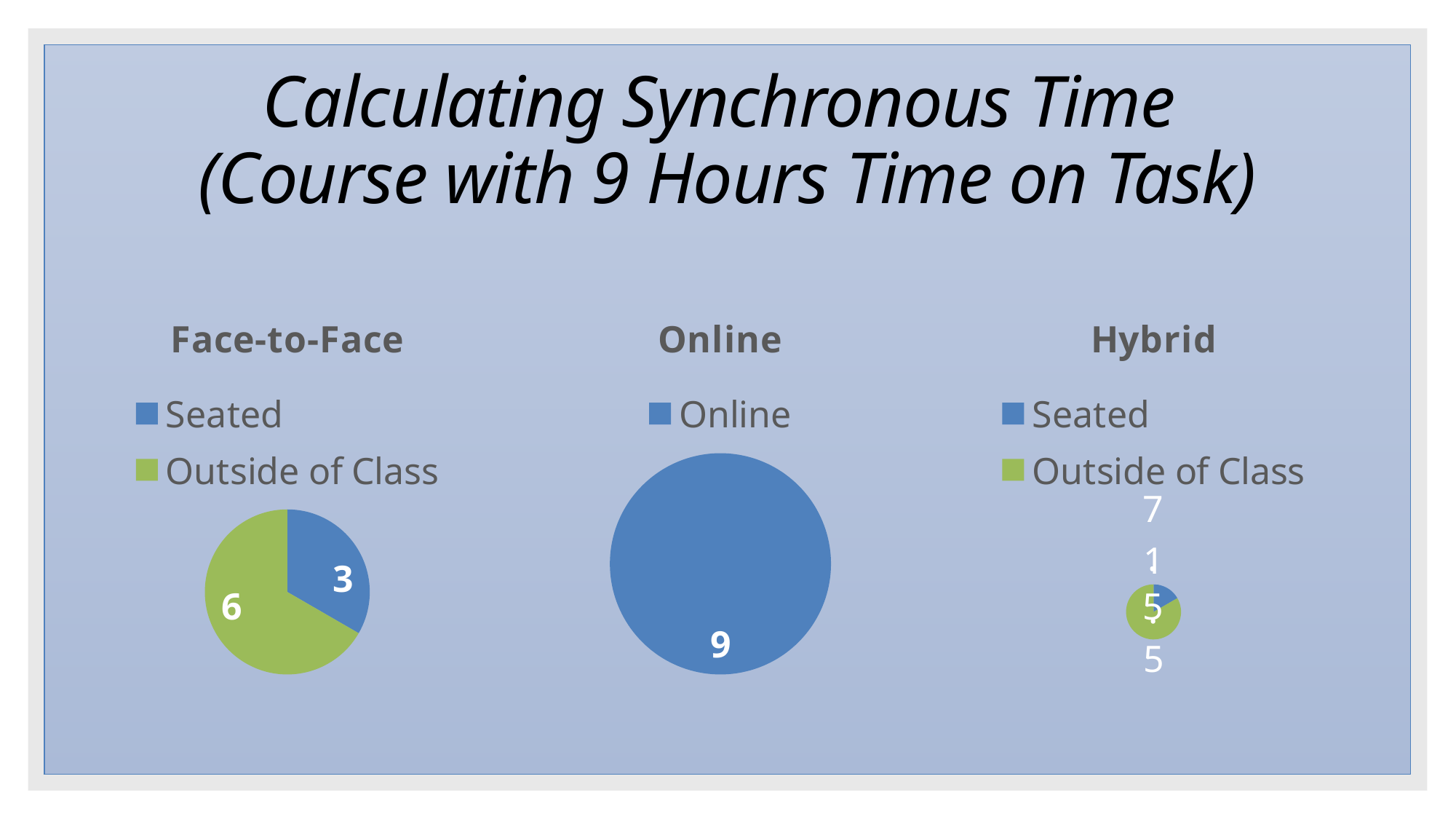
What kind of chart is the Face-to-Face chart? Pie chart In the Face-to-Face chart, what is the difference between Outside of Class and Seated? 3 In the Online chart, what is the value for Online? 9 What are the legend entries of the Hybrid chart? Seated, Outside of Class In the Face-to-Face chart, what colour is the Seated slice? Blue How many entries does the legend of the Online chart list? 1 In the Face-to-Face chart, what is the value for Outside of Class? 6 How many entries does the legend of the Face-to-Face chart list? 2 In the Face-to-Face chart, which slice is larger, Seated or Outside of Class? Outside of Class In the Face-to-Face chart, what is the value for Seated? 3 In the Face-to-Face chart, what share of the pie does Outside of Class represent? Two thirds How many slices does the Online chart have? 1